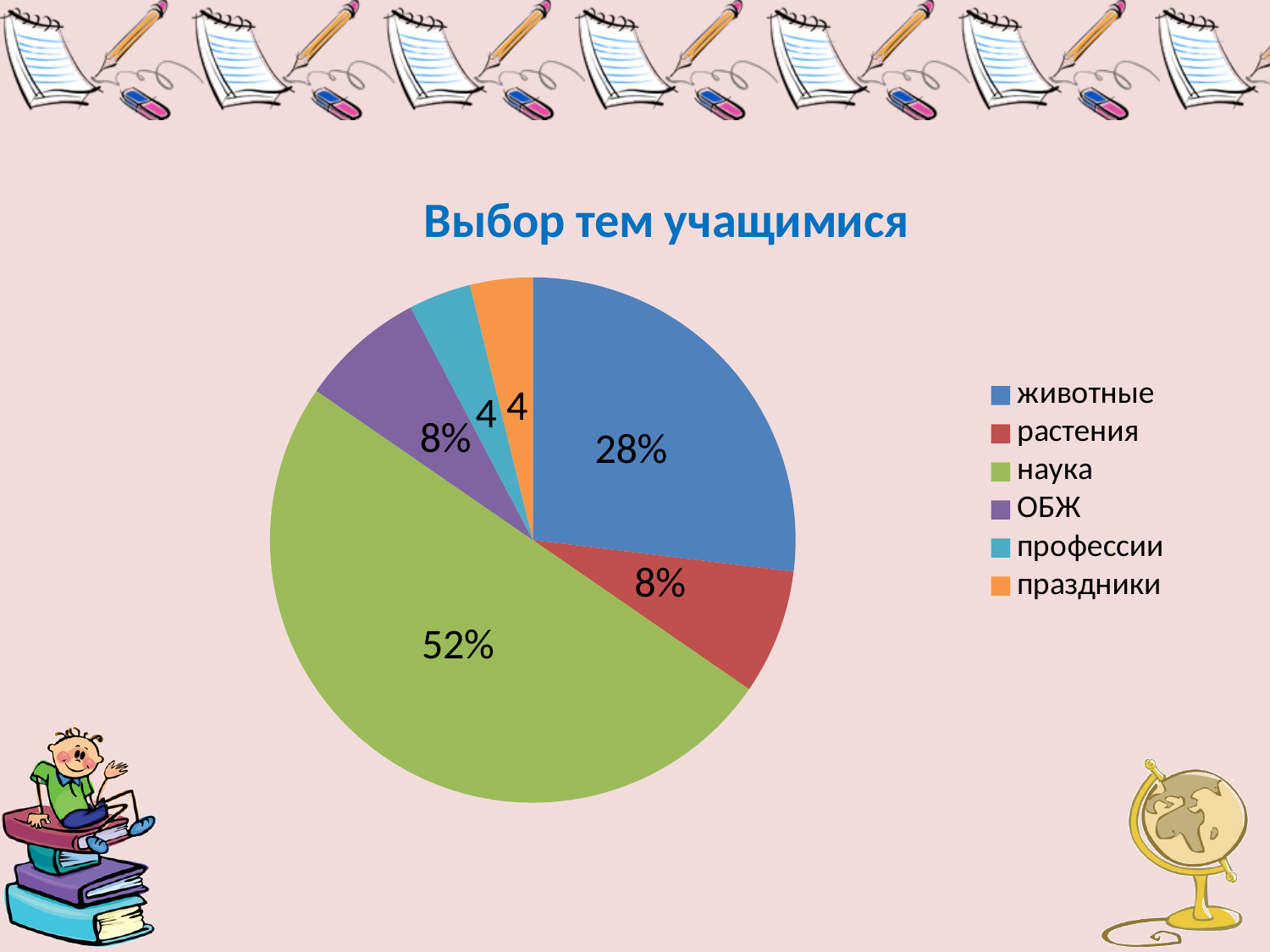
Which category has the largest slice of the pie? наука What is the difference between the values for "наука" and "животные"? 24% What kind of chart is shown on the slide? pie chart What is the value shown for the slice "профессии"? 4 Which colour represents "праздники" in the pie chart? orange What is the title of the chart? Выбор тем учащимися What is the value shown for the slice "растения"? 8% What is the value shown for the slice "животные"? 28% What is the value shown for the slice "ОБЖ"? 8% Which is larger, the slice for "животные" or the slice for "растения"? животные How many categories does the legend of the pie chart list? 6 What is the value shown for the slice "наука"? 52%